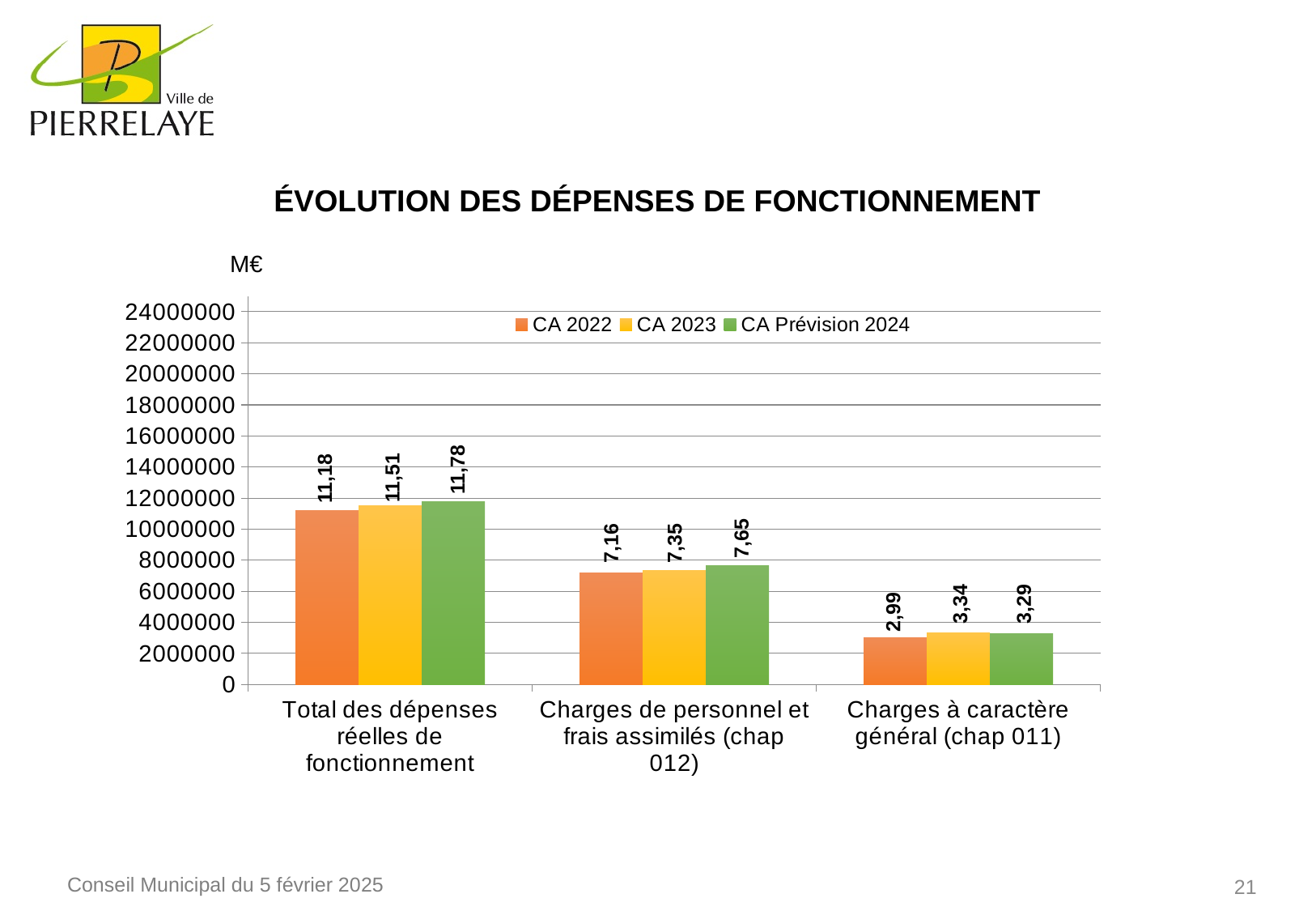
What kind of chart is shown on the slide? bar chart What is the CA 2022 value for Total des dépenses réelles de fonctionnement? 11,18 For Charges à caractère général (chap 011), which is larger: CA 2023 or CA Prévision 2024? CA 2023 What is the CA 2023 value for Charges à caractère général (chap 011)? 3,34 Is the CA 2023 bar for Charges de personnel et frais assimilés (chap 012) greater or less than 8000000 on the axis? less Which category has the lowest CA 2022 value? Charges à caractère général (chap 011) How many series does the legend list? 3 How many categories are shown on the x axis? 3 What is the difference between the CA Prévision 2024 and CA 2022 values for Total des dépenses réelles de fonctionnement? 0,60 Which category has the highest CA Prévision 2024 value? Total des dépenses réelles de fonctionnement What is the title of the chart? ÉVOLUTION DES DÉPENSES DE FONCTIONNEMENT What is the CA Prévision 2024 value for Charges de personnel et frais assimilés (chap 012)? 7,65